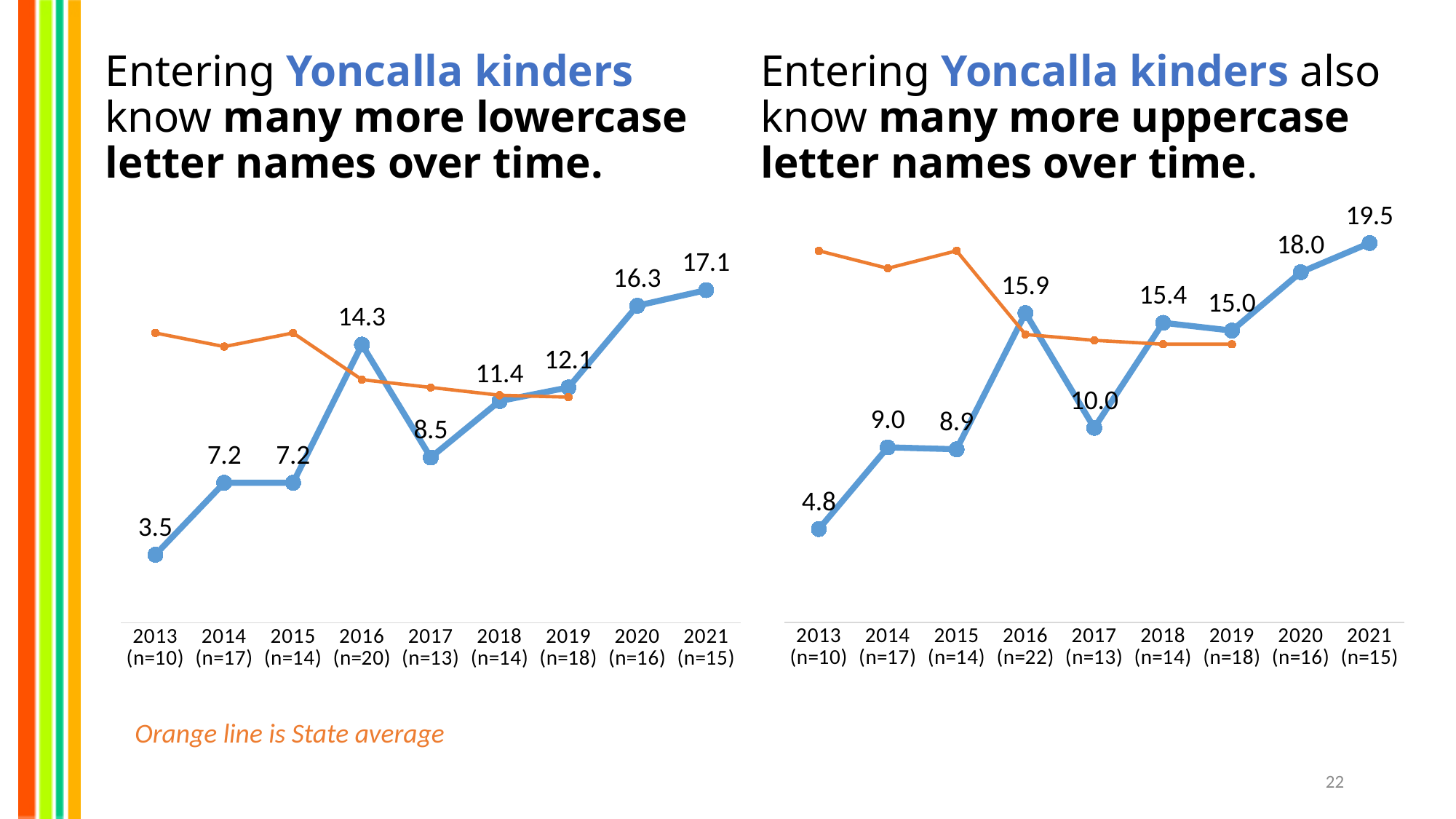
In the left chart (lowercase letter names), what is the Yoncalla value for 2013 (n=10)? 3.5 In the left chart (lowercase letter names), what is the difference between the Yoncalla values for 2021 and 2013? 13.6 In the left chart (lowercase letter names), which year has the lowest Yoncalla value? 2013 In the right chart (uppercase letter names), what is the difference between the Yoncalla values for 2020 and 2019? 3.0 What type of chart is used on this slide? Line chart In the right chart (uppercase letter names), what is the Yoncalla value for 2021 (n=15)? 19.5 In the left chart (lowercase letter names), what is the Yoncalla value for 2016 (n=20)? 14.3 In the left chart (lowercase letter names), which year has the highest Yoncalla value? 2021 In the right chart (uppercase letter names), which is larger, the Yoncalla value for 2016 or for 2018? 2016 In the right chart (uppercase letter names), what is the Yoncalla value for 2017 (n=13)? 10.0 In the left chart (lowercase letter names), how many years are shown on the x axis? 9 In the right chart (uppercase letter names), which year has the lowest Yoncalla value? 2013